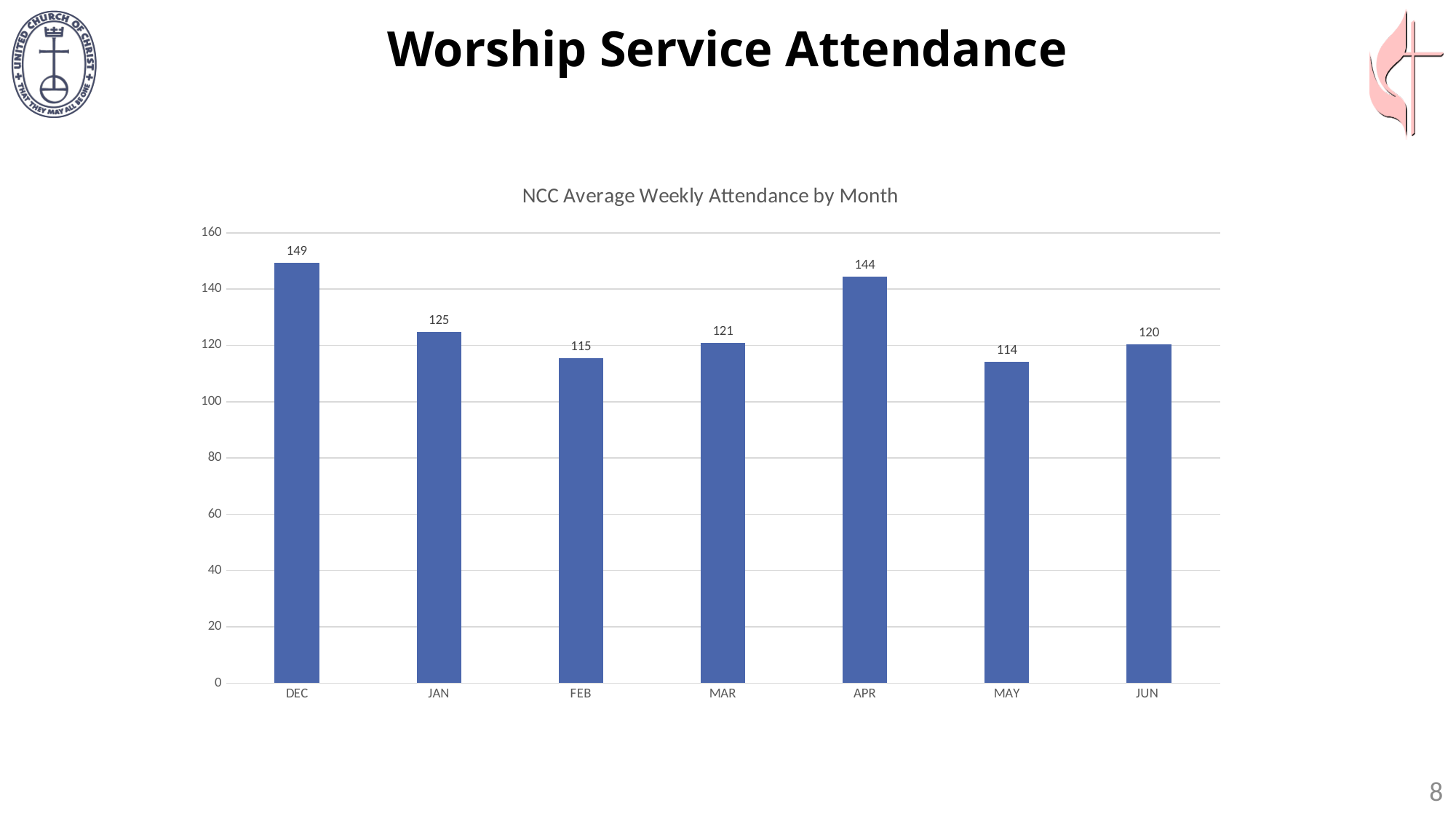
What is the title of the chart? NCC Average Weekly Attendance by Month Which month has a higher average weekly attendance, JAN or JUN? JAN What is the average weekly attendance for DEC? 149 What kind of chart is shown on the slide? Bar chart What is the average weekly attendance for FEB? 115 Which month has the lowest average weekly attendance? MAY Is the value for APR greater or less than 140? greater Which month has the highest average weekly attendance? DEC What is the difference in average weekly attendance between DEC and MAY? 35 What is the average weekly attendance for APR? 144 What is the difference in average weekly attendance between APR and MAR? 23 How many months are shown on the chart? 7